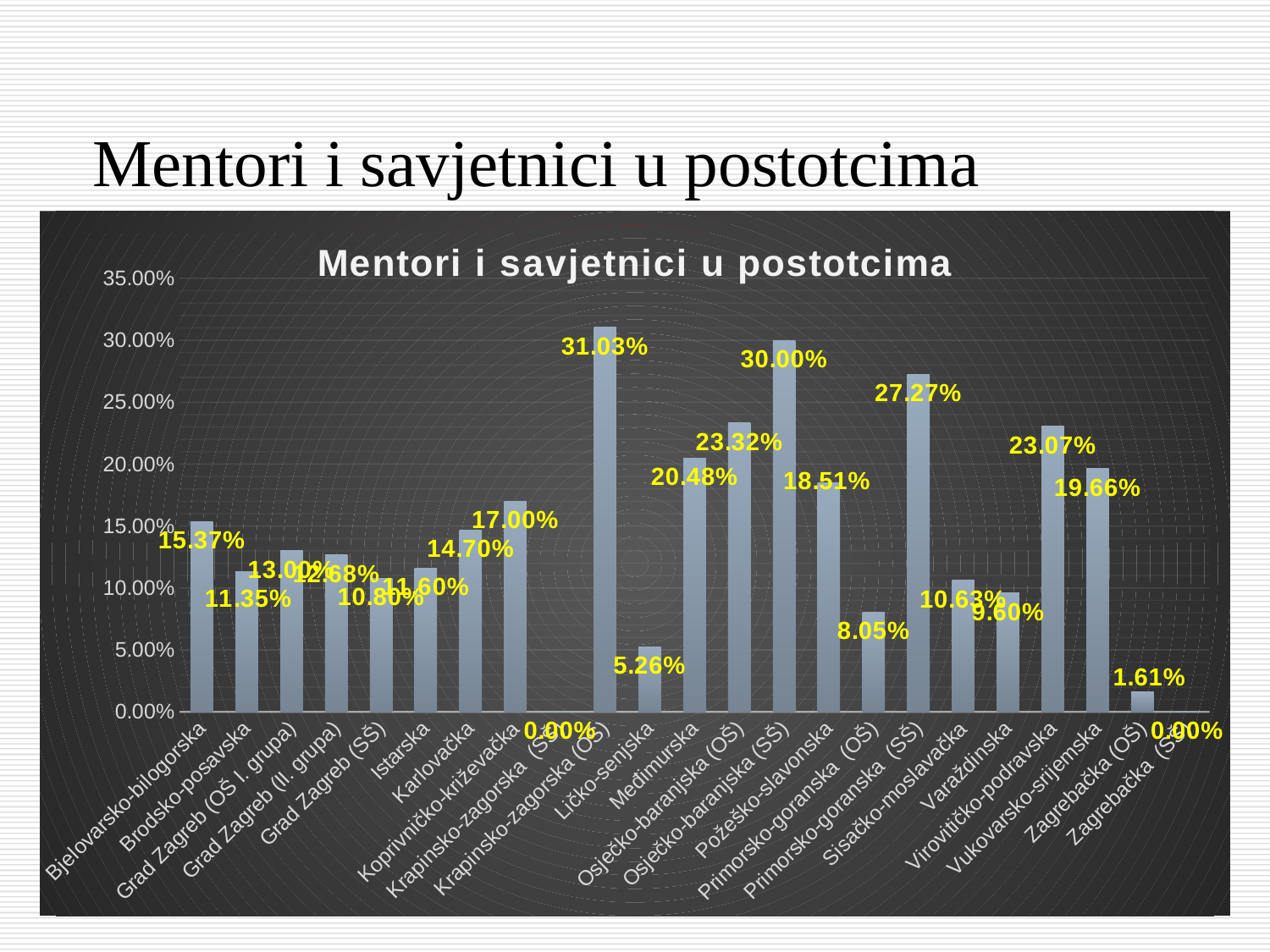
What is the difference between Osječko-baranjska (SŠ) and Osječko-baranjska (OŠ)? 6.68% What is the value for Zagrebačka (OŠ)? 1.61% Which category has the highest value? Krapinsko-zagorska (OŠ) What is the title of the chart? Mentori i savjetnici u postotcima What kind of chart is this? bar chart Which is larger, Virovitičko-podravska or Vukovarsko-srijemska? Virovitičko-podravska Is the value for Požeško-slavonska greater or less than 15.00%? greater How many categories are shown on the x axis? 23 What is the value for Ličko-senjska? 5.26% What is the value for Primorsko-goranska (SŠ)? 27.27% What is the value for Međimurska? 20.48% What is the difference between Krapinsko-zagorska (OŠ) and Osječko-baranjska (SŠ)? 1.03%